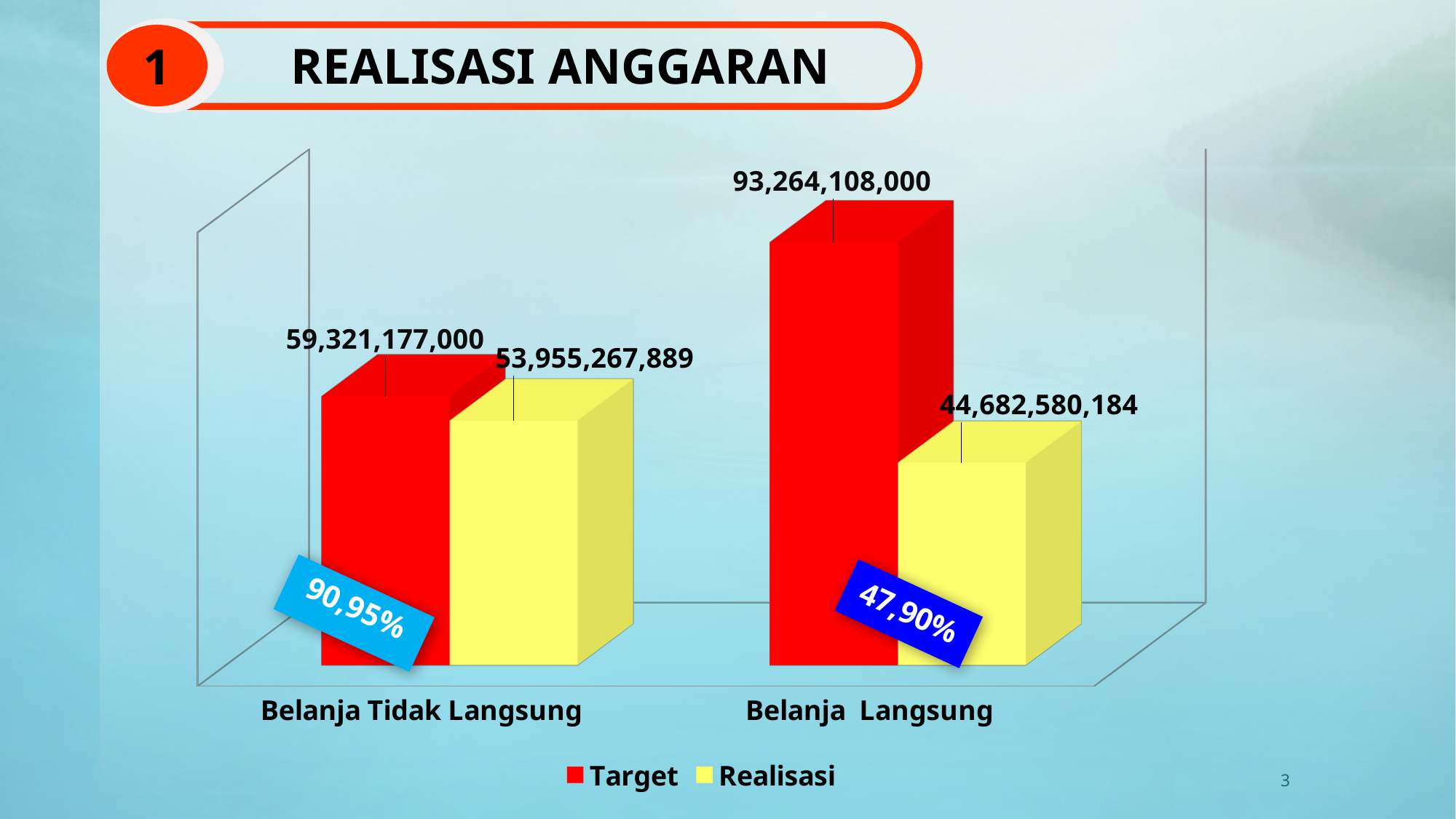
Which category has the lowest Realisasi value? Belanja Langsung What is the Target value for Belanja Langsung? 93,264,108,000 Which is larger for Belanja Tidak Langsung: Target or Realisasi? Target What is the Target value for Belanja Tidak Langsung? 59,321,177,000 What is the difference between Target and Realisasi for Belanja Langsung? 48,581,527,816 How many categories are shown on the x axis? 2 What is the Realisasi value for Belanja Langsung? 44,682,580,184 What type of chart is shown on the slide? Bar chart Which category has the highest Target value? Belanja Langsung How many series does the legend list? 2 What is the Realisasi value for Belanja Tidak Langsung? 53,955,267,889 What is the difference between Target and Realisasi for Belanja Tidak Langsung? 5,365,909,111